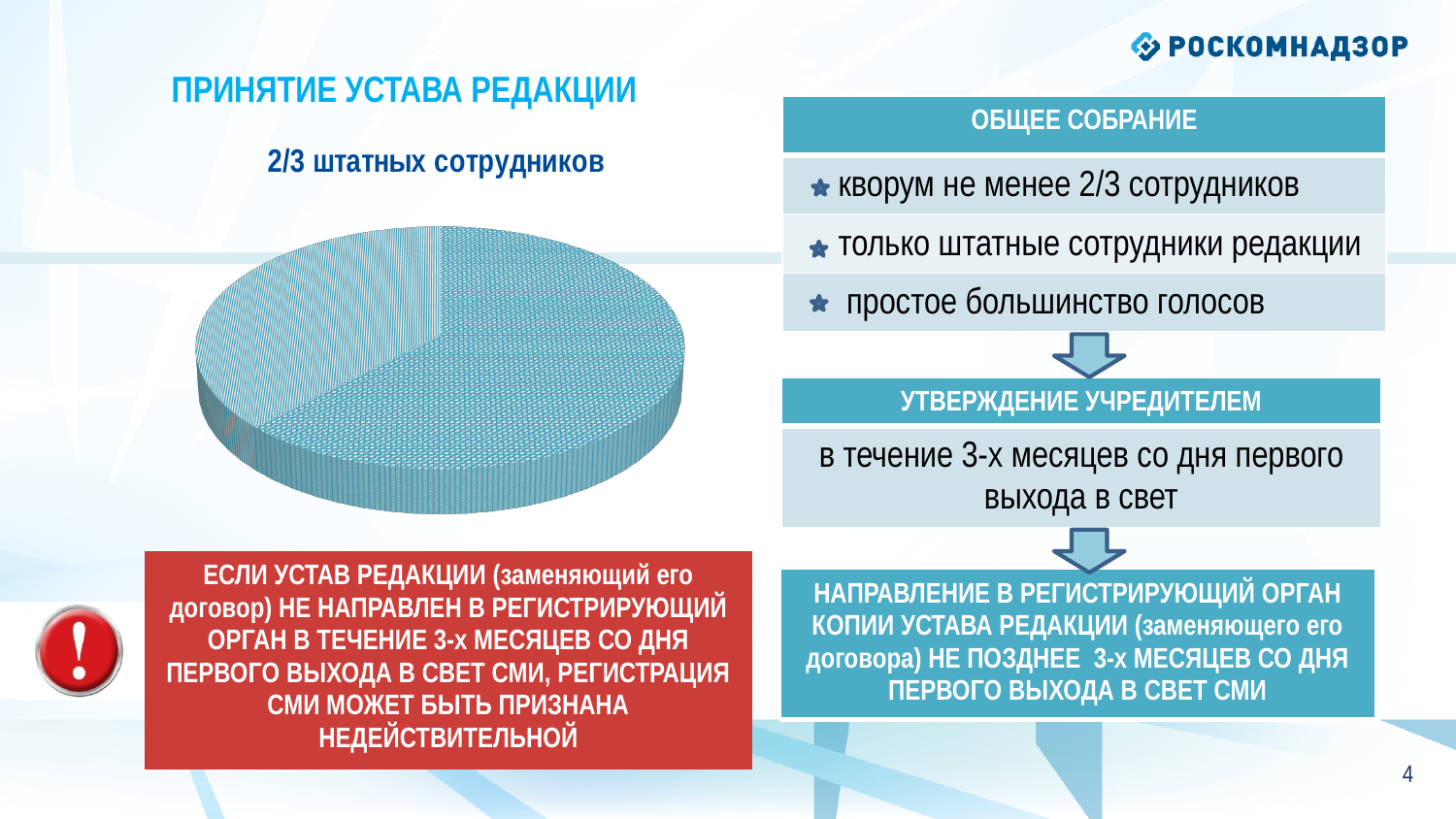
What kind of chart is shown on the left of the slide? pie chart How many slices does the pie chart have? 2 Does the larger slice of the pie chart take up more or less than half of the pie? more Does the smaller slice of the pie chart take up more or less than half of the pie? less What heading is printed directly above the pie chart? 2/3 штатных сотрудников Does the pie chart have a legend? No